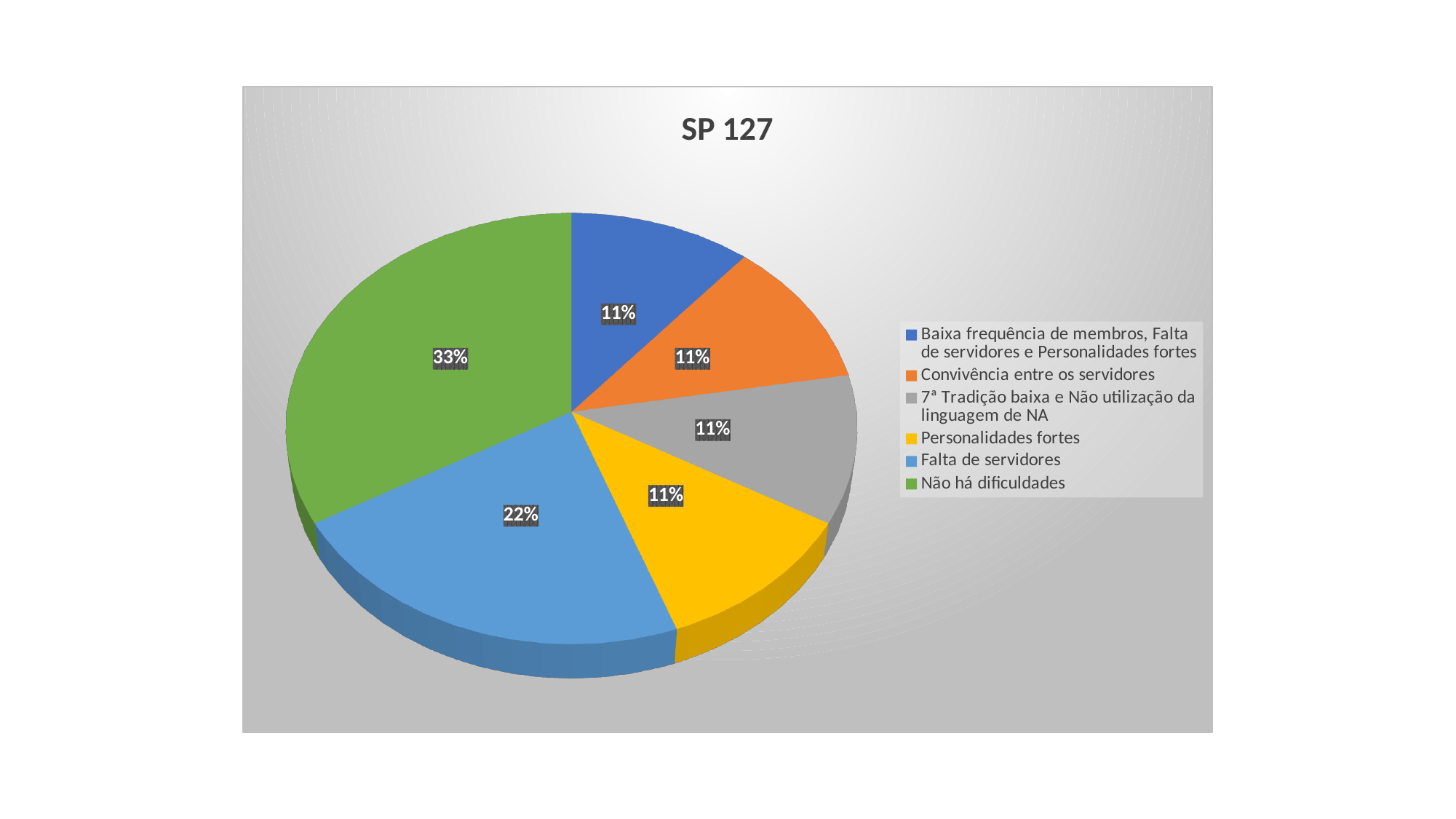
How many entries does the legend list? 6 What is the value for "Personalidades fortes"? 11% What share of the pie does "Falta de servidores" represent? 22% What is the difference between the share for "Não há dificuldades" and the share for "Falta de servidores"? 11% Which category has the largest slice of the pie? Não há dificuldades Which is larger: the share for "Falta de servidores" or the share for "Personalidades fortes"? Falta de servidores How many slices does the pie chart have? 6 What colour is the slice for "Não há dificuldades"? green What kind of chart is shown on the slide? pie chart What is the title of the chart? SP 127 What is the value for "Convivência entre os servidores"? 11% What share of the pie does "Não há dificuldades" represent? 33%